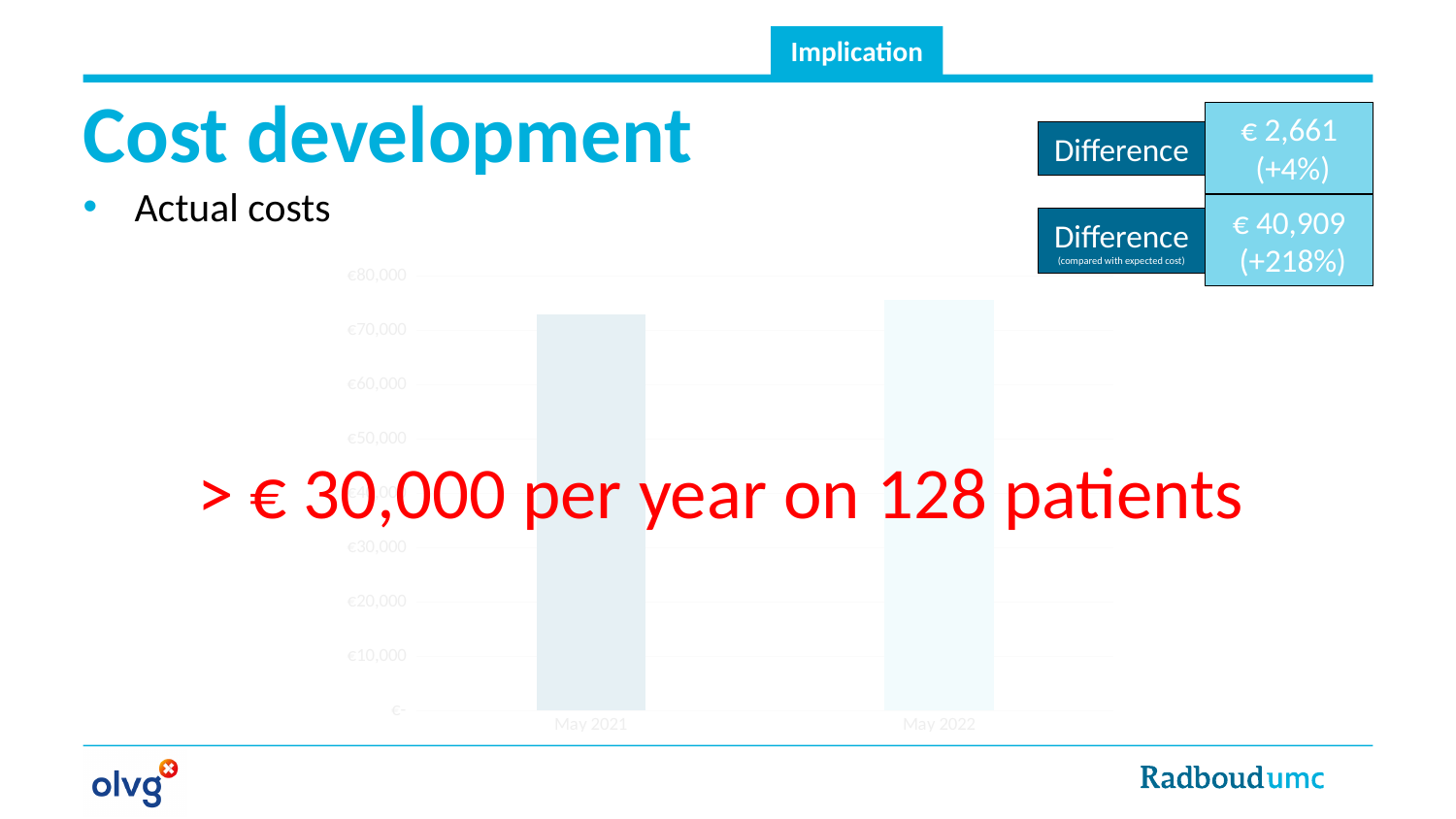
Is the value for May 2021 greater or less than €80,000? less What kind of chart is shown on the slide? bar chart What are the two categories on the x axis of the chart? May 2021 and May 2022 What is the highest tick value shown on the y axis of the chart? €80,000 Is the value for May 2022 greater or less than €60,000? greater Is the value for May 2022 greater or less than €80,000? less How many categories are shown on the x axis of the chart? 2